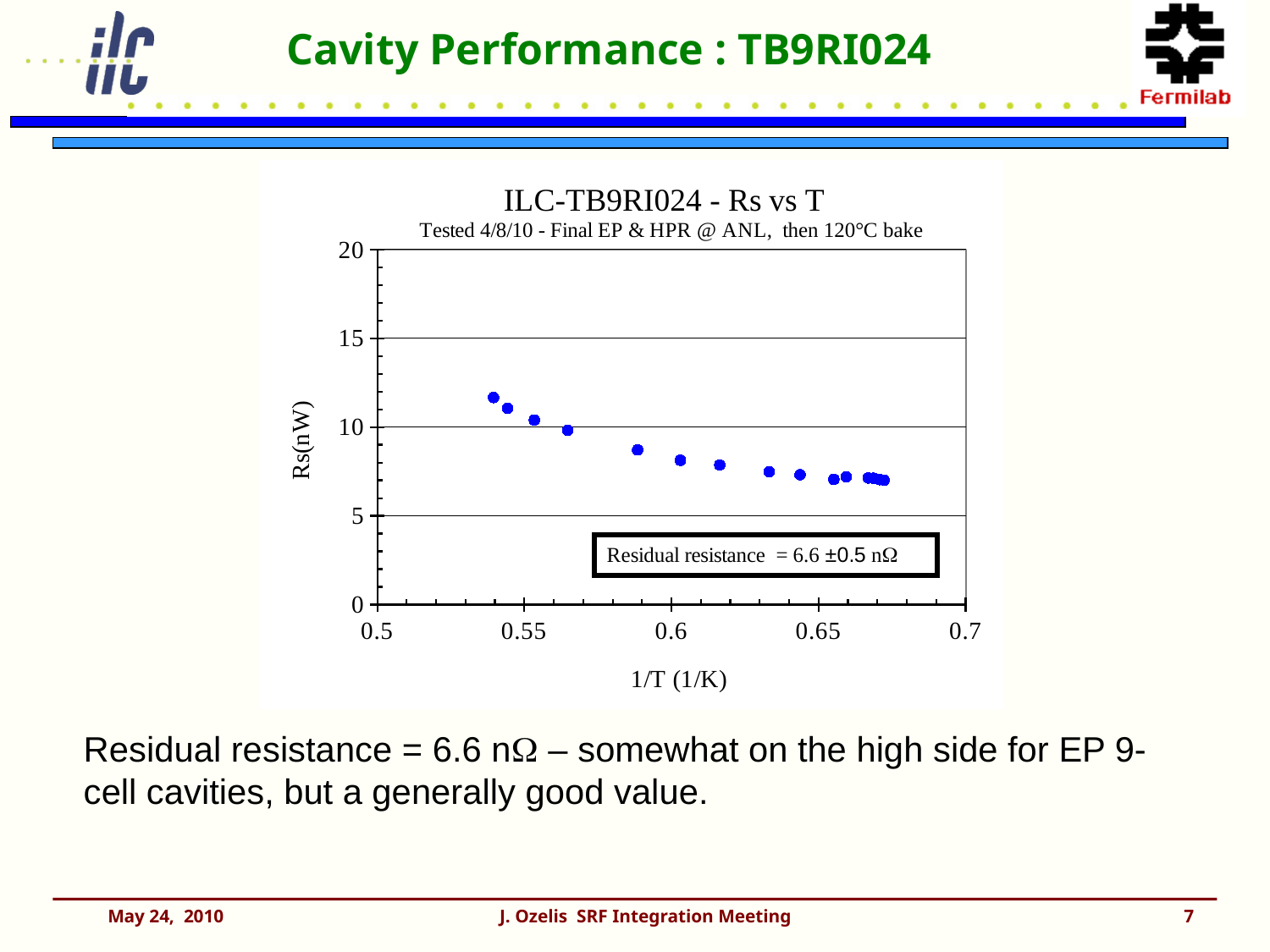
What is the title of the chart? ILC-TB9RI024 - Rs vs T What is the maximum value shown on the y axis of the chart? 20 Which has the higher Rs value: the data point near 1/T = 0.54 or the data point near 1/T = 0.65? the point near 1/T = 0.54 Is the Rs value of the rightmost data points (near 1/T = 0.67) greater or less than 10? less What is the label of the x axis of the chart? 1/T (1/K) What residual resistance value is stated in the box on the chart? 6.6 ±0.5 nΩ As 1/T increases along the x axis, do the Rs values rise or fall? fall Is the Rs value of the rightmost data points (near 1/T = 0.67) greater or less than 5? greater Which data point has the highest Rs value: the one at the smallest 1/T or the one at the largest 1/T? the one at the smallest 1/T What kind of chart is shown on the slide? scatter chart Is the Rs value of the data point near 1/T = 0.59 greater or less than 10? less